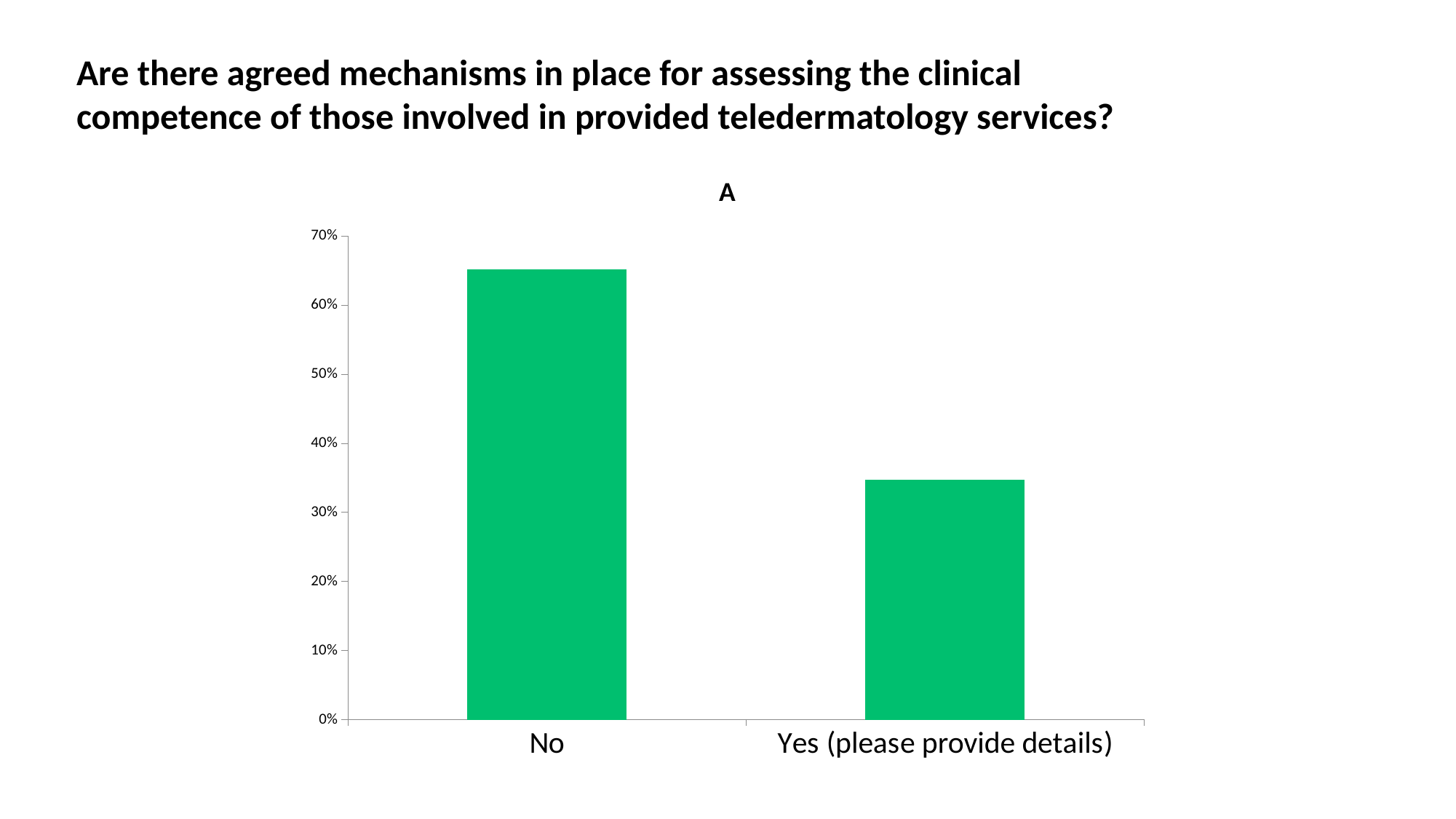
What kind of chart is shown on the slide? bar chart Is the value for Yes (please provide details) greater or less than 40%? less Is the value for No greater or less than 60%? greater How many categories are shown on the x axis of the chart? 2 Is the value for Yes (please provide details) greater or less than 30%? greater What colour are the bars in the chart? green Which category has the highest value in the chart? No Which is larger, the value for No or the value for Yes (please provide details)? No What is the highest value shown on the y axis of the chart? 70% What is the title of the chart? A Which category has the lowest value in the chart? Yes (please provide details)